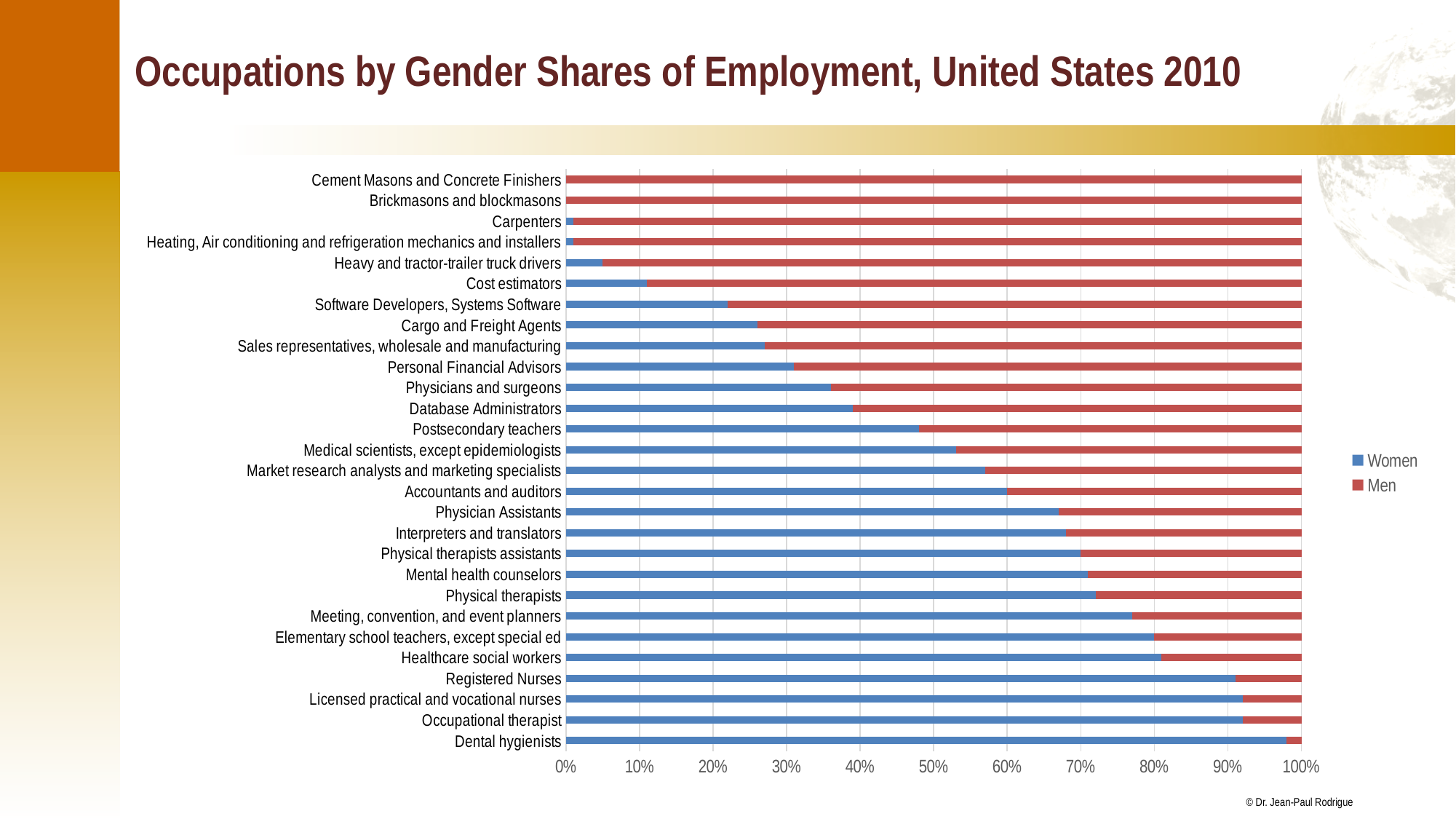
Which has a larger share of women: Physical therapists or Cost estimators? Physical therapists Is the share of women for Dental hygienists greater or less than 90%? greater Is the share of women for Postsecondary teachers greater or less than 50%? less What is the total of the stacked bar for Registered Nurses? 100% Is the share of women for Cost estimators greater or less than 20%? less Which occupation has the highest share of women? Dental hygienists How many occupations are plotted on the chart? 28 What kind of chart is shown on the slide? Stacked bar chart Which has a larger share of men: Carpenters or Registered Nurses? Carpenters How many series does the legend list? 2 Which colour represents Women in the chart? Blue